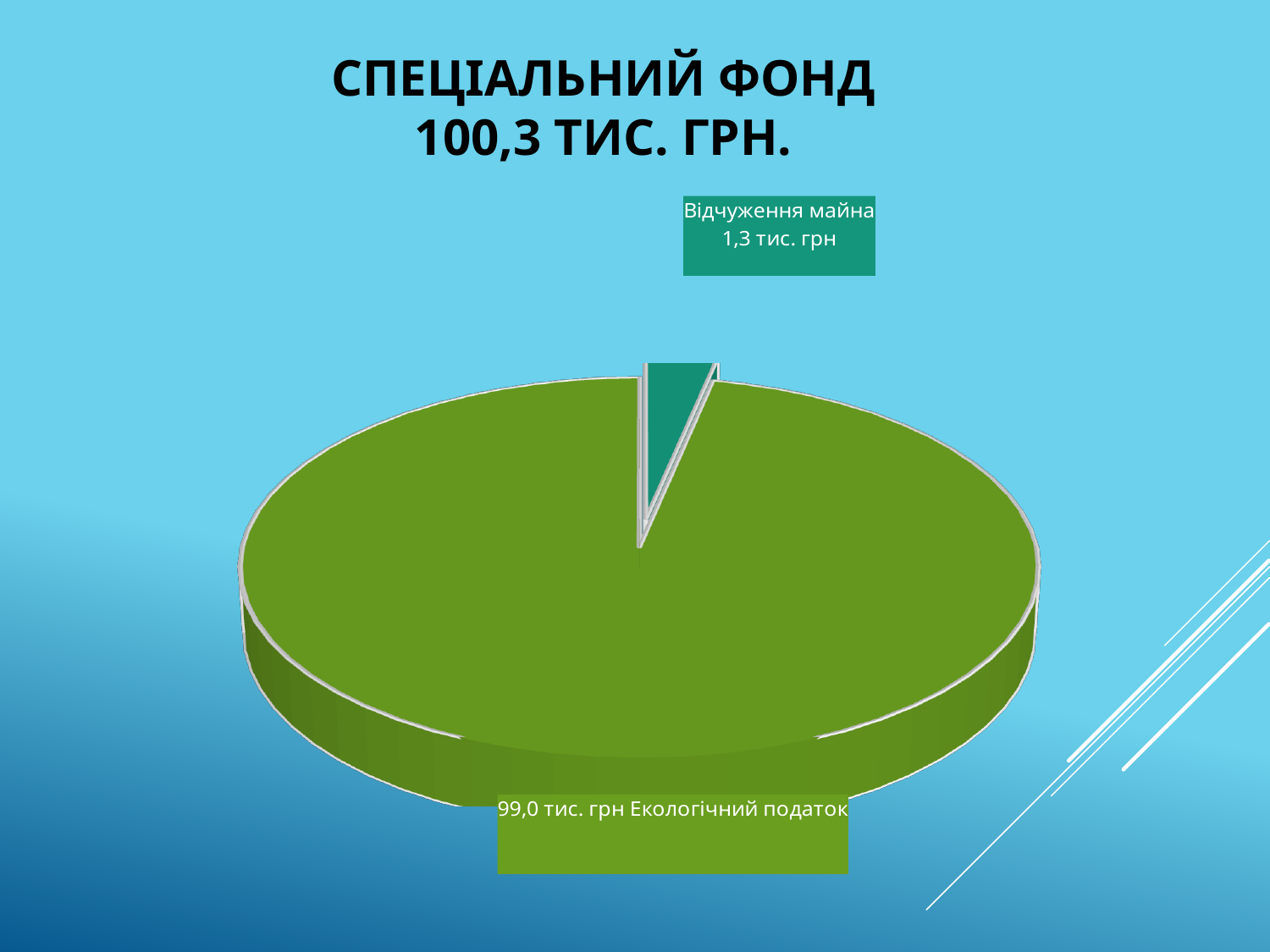
Which is larger, Екологічний податок or Відчуження майна? Екологічний податок What is the title of the slide above the chart? СПЕЦІАЛЬНИЙ ФОНД 100,3 ТИС. ГРН. What is the value for Відчуження майна in the pie chart? 1,3 тис. грн What colour is the slice for Відчуження майна? Teal (dark green) What is the total of the two slices in the pie chart? 100,3 тис. грн How many slices does the pie chart have? 2 What is the difference between the values for Екологічний податок and Відчуження майна? 97,7 тис. грн Which category has the largest slice of the pie chart? Екологічний податок Which category has the smallest slice of the pie chart? Відчуження майна What kind of chart is shown on the slide? Pie chart What is the value for Екологічний податок in the pie chart? 99,0 тис. грн